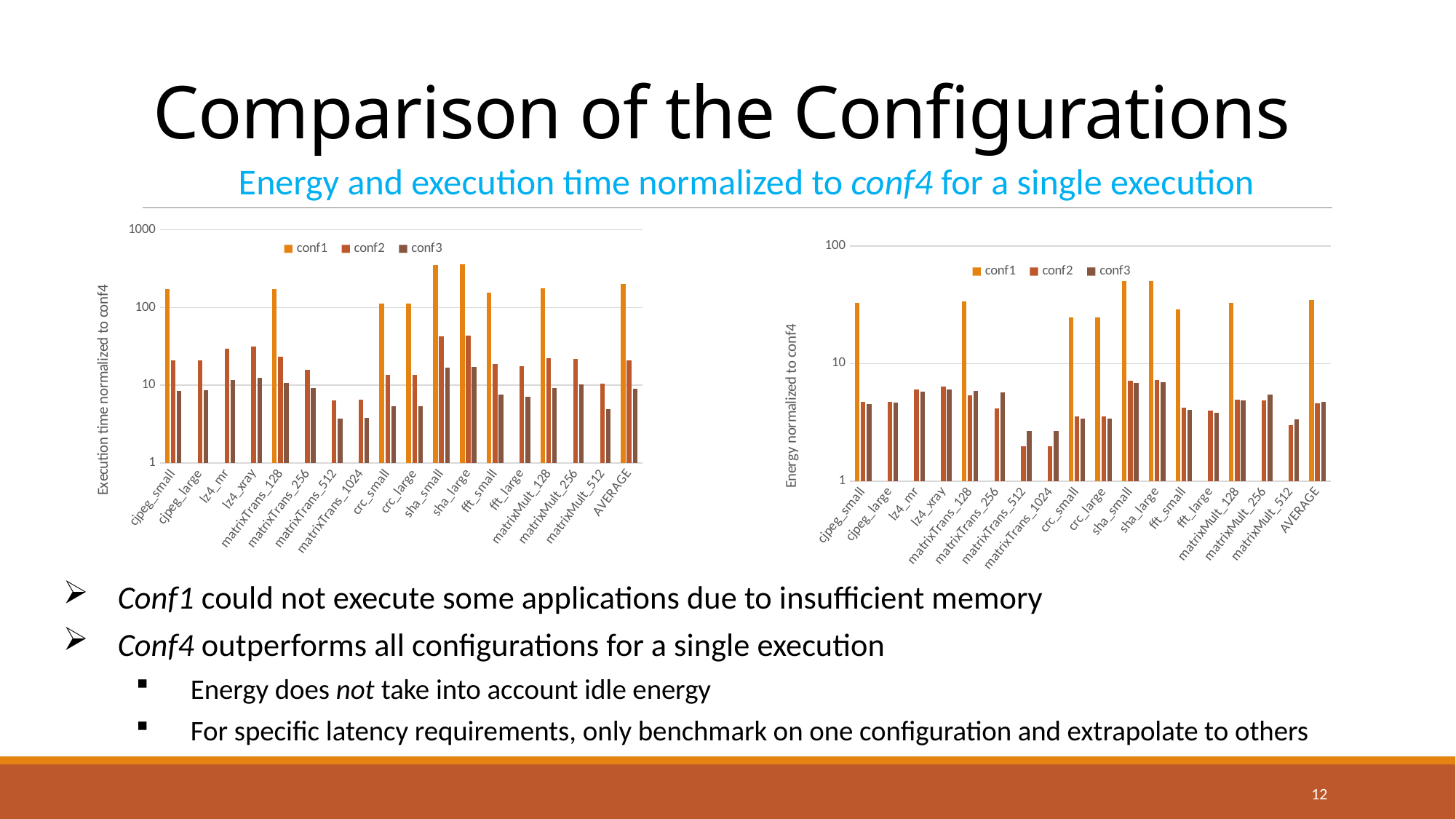
What kind of chart is the left chart (execution time normalized to conf4)? bar chart In the right chart (energy normalized to conf4), which is larger for crc_small, conf1 or conf2? conf1 In the right chart (energy normalized to conf4), is the conf1 value for cjpeg_small greater or less than 10? greater In the left chart (execution time normalized to conf4), is the conf1 value for sha_small greater or less than 100? greater What is the y-axis label of the right chart? Energy normalized to conf4 What are the legend entries of the left chart (execution time normalized to conf4)? conf1, conf2, conf3 In the right chart (energy normalized to conf4), is the conf2 value for matrixTrans_512 greater or less than 10? less In the left chart (execution time normalized to conf4), which is larger for cjpeg_small, conf2 or conf3? conf2 How many categories are shown on the x axis of the left chart (execution time normalized to conf4)? 18 How many series does the legend of the right chart (energy normalized to conf4) list? 3